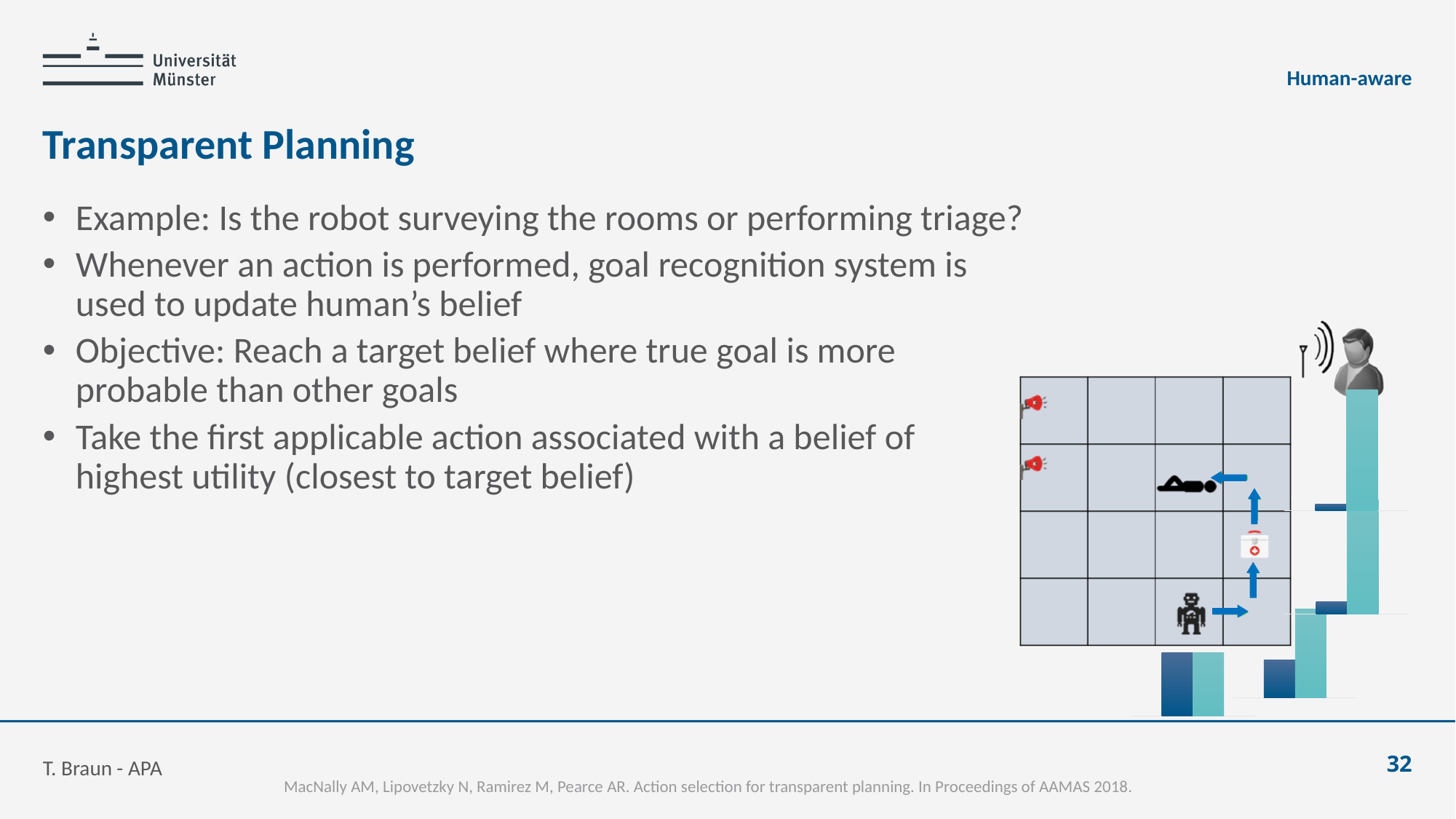
In the bar chart at the bottom right, do the teal bars rise or fall from left to right? rise In the bar chart at the bottom right, which group of bars has the shortest teal bar? the leftmost group In the bar chart at the bottom right, which teal bar is taller: the leftmost one or the rightmost one? the rightmost one What two colours are used for the bars in the chart at the bottom right of the slide? dark blue and teal In the bar chart at the bottom right, which group of bars has the tallest teal bar? the rightmost group In the bar chart at the bottom right, is the dark blue bar in the rightmost group taller or shorter than the teal bar next to it? shorter What kind of chart is shown in the bottom-right corner of the slide? bar chart